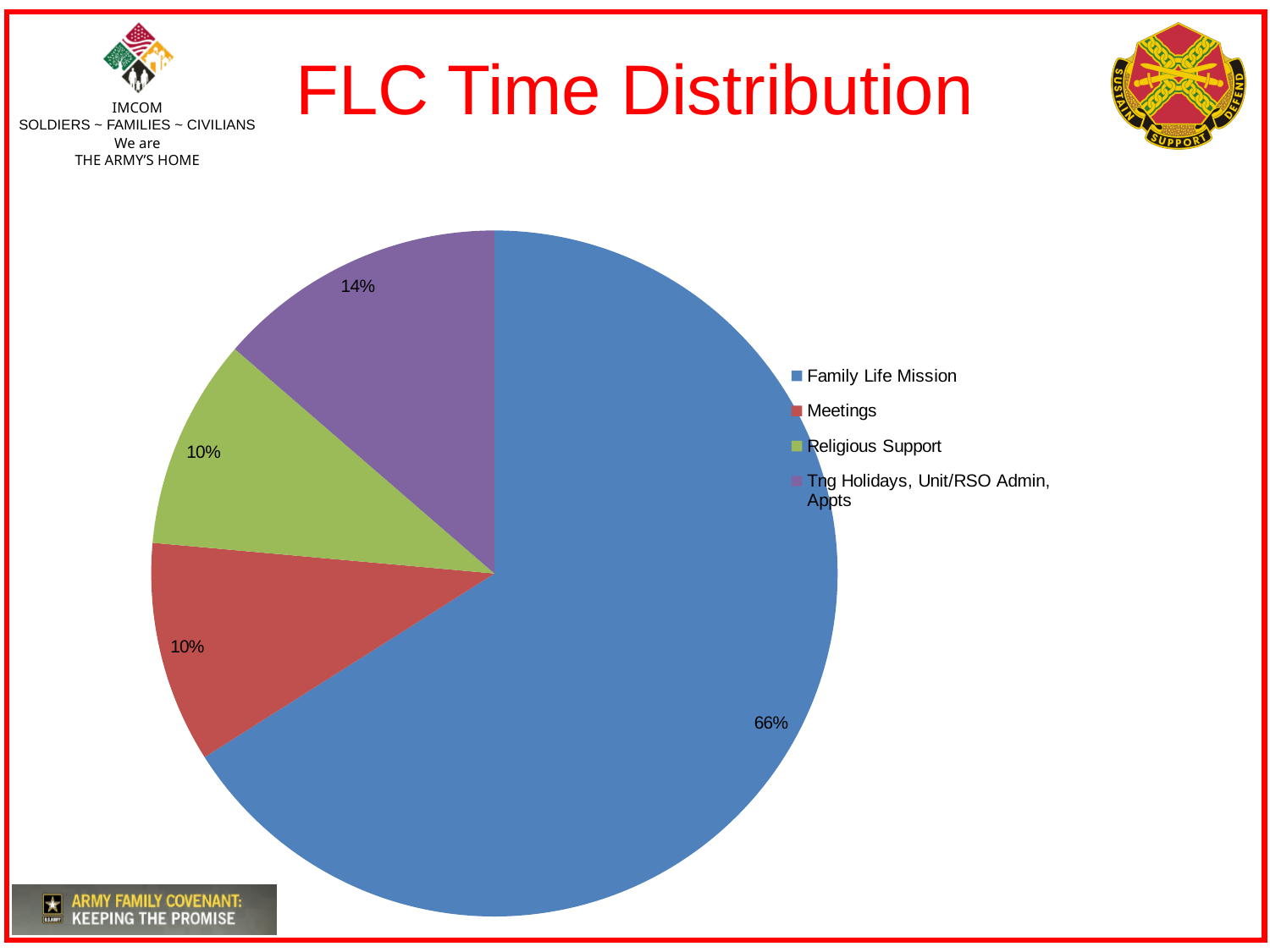
What type of chart is shown on the slide? Pie chart What is the title of the chart? FLC Time Distribution Which is larger, the share for Tng Holidays, Unit/RSO Admin, Appts or the share for Meetings? Tng Holidays, Unit/RSO Admin, Appts What percentage of time is shown for Tng Holidays, Unit/RSO Admin, Appts? 14% What percentage of time is shown for Meetings? 10% What is the difference in percentage points between Family Life Mission and Tng Holidays, Unit/RSO Admin, Appts? 52 What percentage of time is shown for Family Life Mission? 66% How many categories does the legend list? 4 What percentage of time is shown for Religious Support? 10% What is the combined share of Meetings and Religious Support? 20% What colour is the slice for Family Life Mission? Blue Which category has the largest share of the pie? Family Life Mission